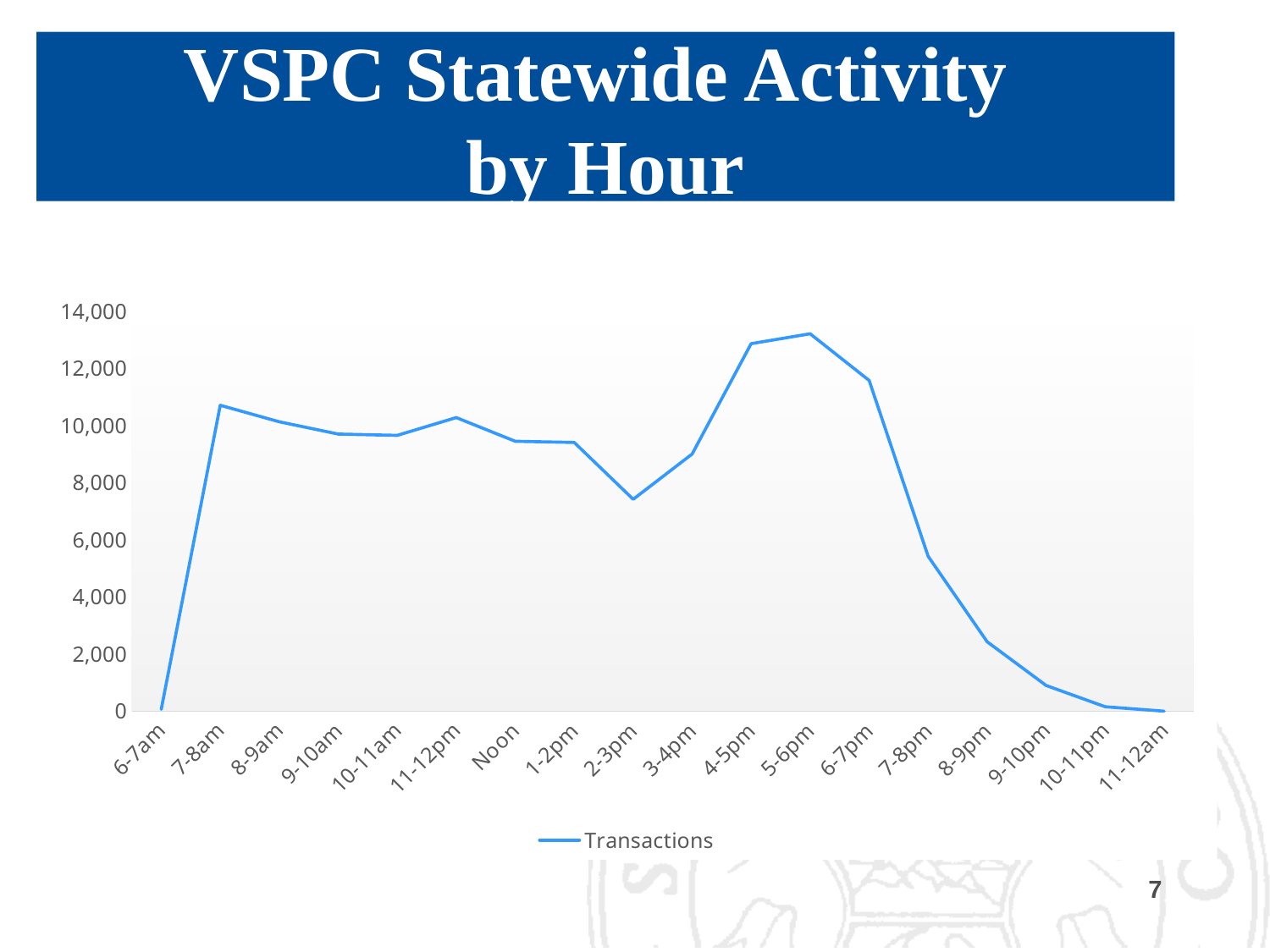
Is the value for 6-7pm greater or less than 10,000? greater Which has more transactions, 5-6pm or 2-3pm? 5-6pm Is the value for 2-3pm greater or less than 8,000? less What kind of chart is shown on the slide? line chart Is the value for 7-8am greater or less than 10,000? greater How many series does the legend list? 1 How many hourly categories are plotted along the x axis? 18 Which has more transactions, 7-8am or 7-8pm? 7-8am What is the name of the series shown in the legend? Transactions Which hour has the highest number of transactions? 5-6pm Do transactions rise or fall from 5-6pm through 11-12am? fall